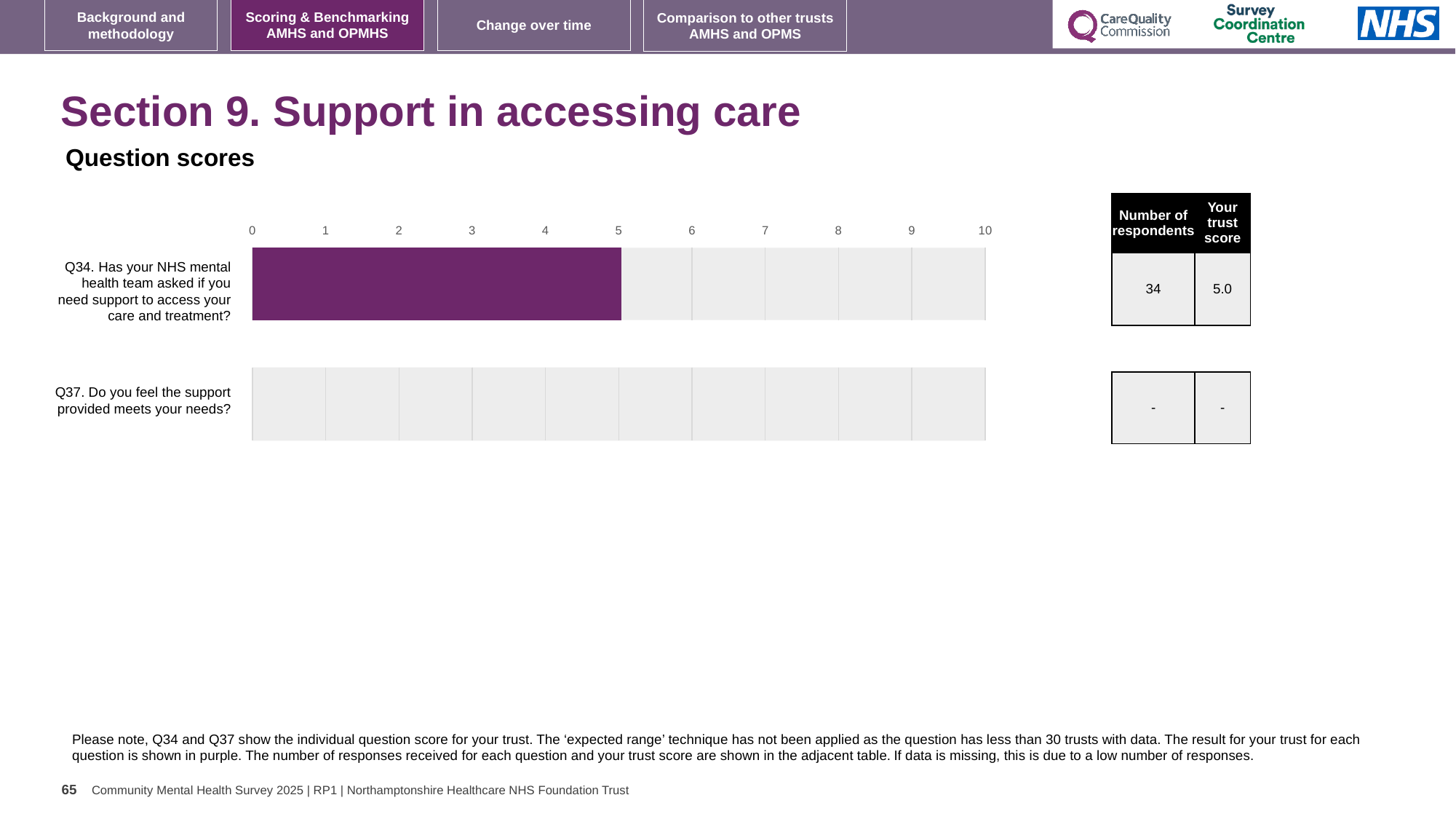
What kind of chart is used to show the question scores? Bar chart What are the two column headings of the table next to the chart? Number of respondents; Your trust score Is the score for Q34 greater or less than 6? less What is the maximum value shown on the chart's axis? 10 Which question has a purple bar plotted on the chart? Q34 How many questions are listed on the chart? 2 Is the score for Q34 greater or less than 4? greater How many respondents answered Q34? 34 What is shown as the trust score for Q37 (Do you feel the support provided meets your needs?)? - Which question has no bar plotted because data is missing? Q37 What is the trust score for Q34 (Has your NHS mental health team asked if you need support to access your care and treatment?)? 5.0